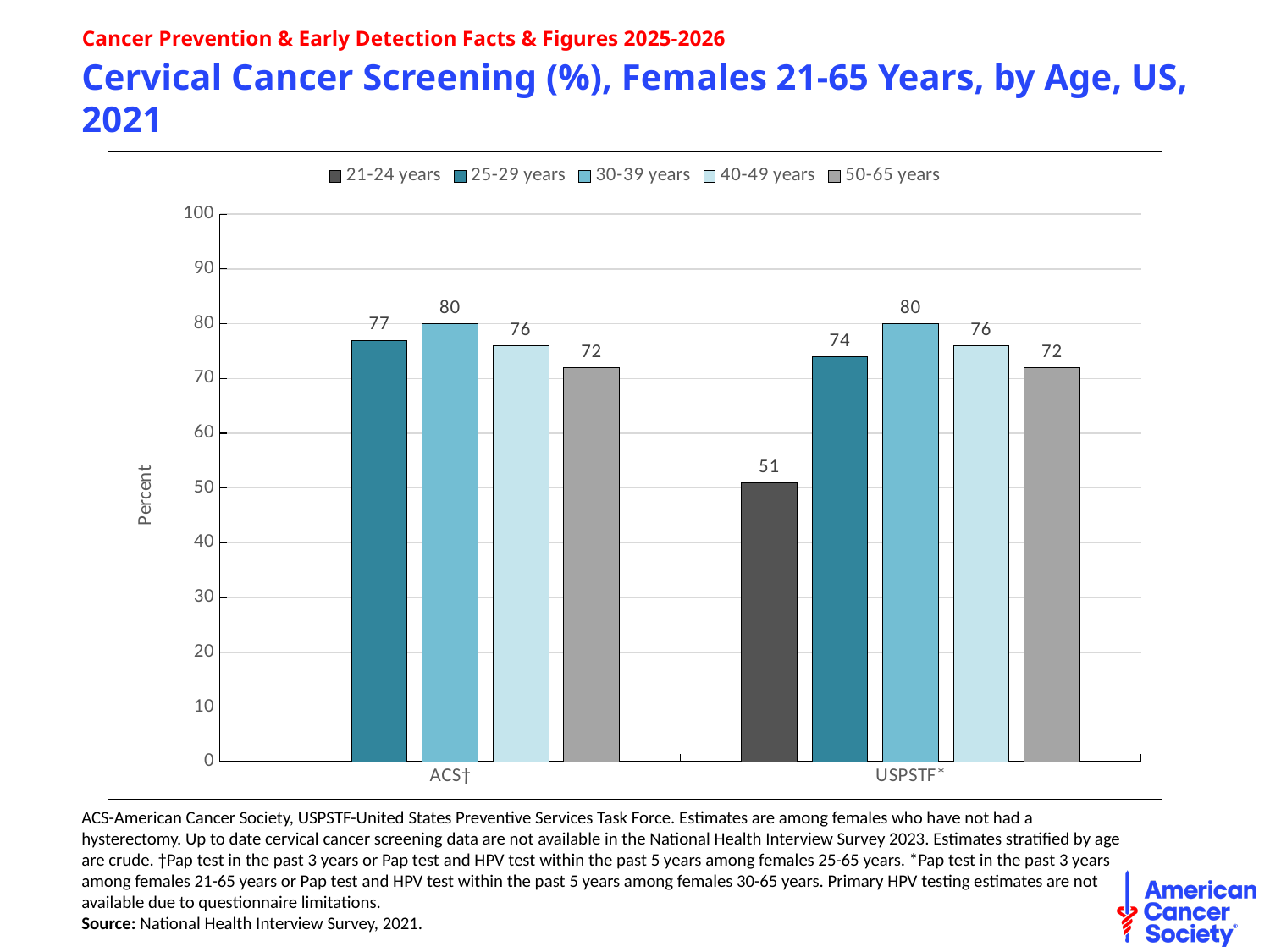
What is the difference between the 25-29 years screening percentage under ACS† and under USPSTF*? 3 What is the label on the vertical axis of the chart? Percent Which age group has the highest screening percentage under the ACS† guideline? 30-39 years What is the screening percentage for females aged 21-24 years under the USPSTF* guideline? 51 Which is larger: the 40-49 years value under ACS† or the 50-65 years value under ACS†? 40-49 years under ACS† Which age group has the lowest screening percentage under the USPSTF* guideline? 21-24 years How many age-group series does the legend list? 5 Is the value for 21-24 years under USPSTF* greater or less than 60? less What is the screening percentage for females aged 50-65 years under the USPSTF* guideline? 72 What kind of chart is shown on the slide? Bar chart What is the difference between the 30-39 years and 21-24 years screening percentages under the USPSTF* guideline? 29 What is the cervical cancer screening percentage for females aged 25-29 years under the ACS† guideline? 77